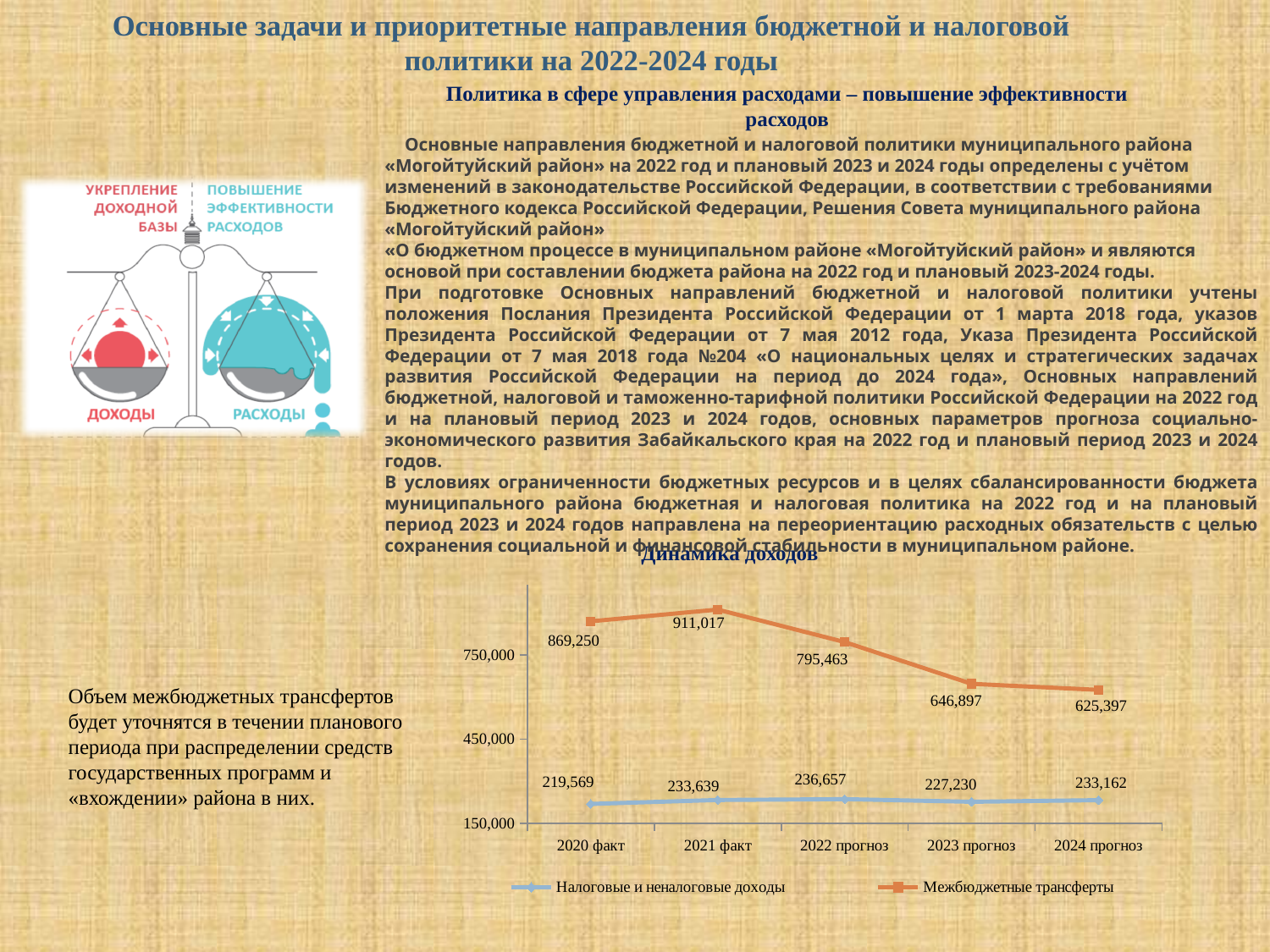
Что больше на диаграмме «Динамика доходов»: налоговые и неналоговые доходы за 2021 факт или за 2023 прогноз? 2021 факт Сколько категорий (периодов) показано по оси x на диаграмме «Динамика доходов»? 5 Сколько рядов данных указано в легенде диаграммы «Динамика доходов»? 2 Как изменяются межбюджетные трансферты с 2021 факт по 2024 прогноз на диаграмме «Динамика доходов»? снижаются На сколько межбюджетные трансферты за 2020 факт больше, чем за 2024 прогноз, на диаграмме «Динамика доходов»? 243,853 Каково значение налоговых и неналоговых доходов за 2022 прогноз на диаграмме «Динамика доходов»? 236,657 В каком периоде межбюджетные трансферты достигают максимума на диаграмме «Динамика доходов»? 2021 факт Каково значение межбюджетных трансфертов за 2021 факт на диаграмме «Динамика доходов»? 911,017 Значение межбюджетных трансфертов за 2023 прогноз на диаграмме «Динамика доходов» больше или меньше 750,000? меньше Какой тип диаграммы используется на графике «Динамика доходов»? линейная диаграмма В каком периоде налоговые и неналоговые доходы минимальны на диаграмме «Динамика доходов»? 2020 факт Каким цветом показан ряд «Межбюджетные трансферты» на диаграмме «Динамика доходов»? оранжевым